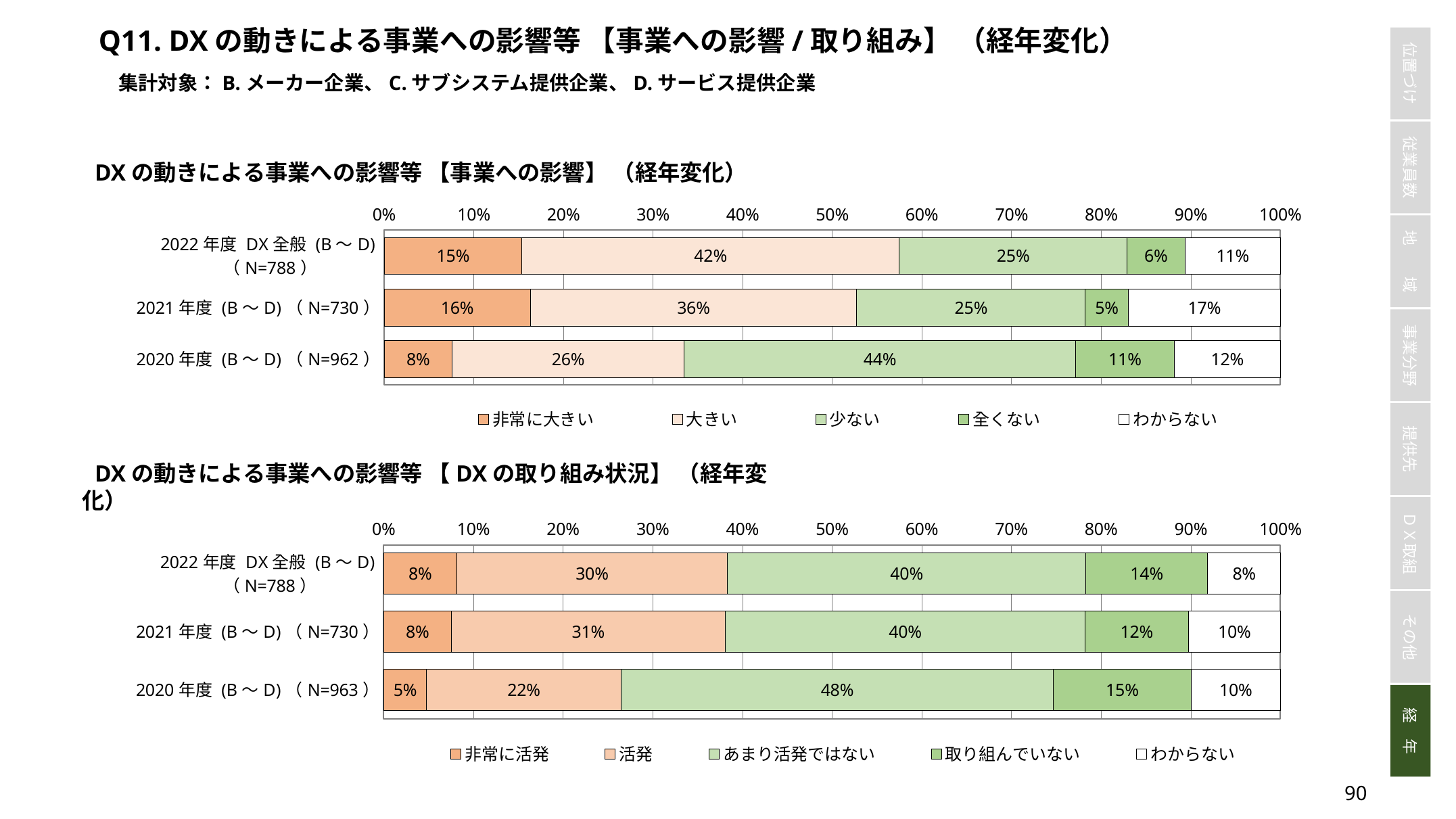
What kind of chart is the top chart (事業への影響)? Stacked horizontal bar chart In the bottom chart (DXの取り組み状況), what is the difference between the 「取り組んでいない」 values for 2020年度 and 2022年度? 1% In the top chart (事業への影響), what is the difference between the 「大きい」 values for 2022年度 and 2020年度? 16% In the bottom chart (DXの取り組み状況), what is the value for 「取り組んでいない」 in 2021年度? 12% In the top chart (事業への影響), which year has the highest value for 「少ない」? 2020年度 In the bottom chart (DXの取り組み状況), what is the value for 「あまり活発ではない」 in 2020年度? 48% In the bottom chart (DXの取り組み状況), which year has the lowest value for 「活発」? 2020年度 How many series does the legend of the bottom chart (DXの取り組み状況) list? 5 How many year categories are shown in the top chart (事業への影響)? 3 In the top chart (事業への影響), what is the value for 「大きい」 in 2022年度? 42% In the top chart (事業への影響), what is the value for 「わからない」 in 2021年度? 17% In the top chart (事業への影響), which is larger: 「非常に大きい」 in 2022年度 or 「非常に大きい」 in 2020年度? 2022年度